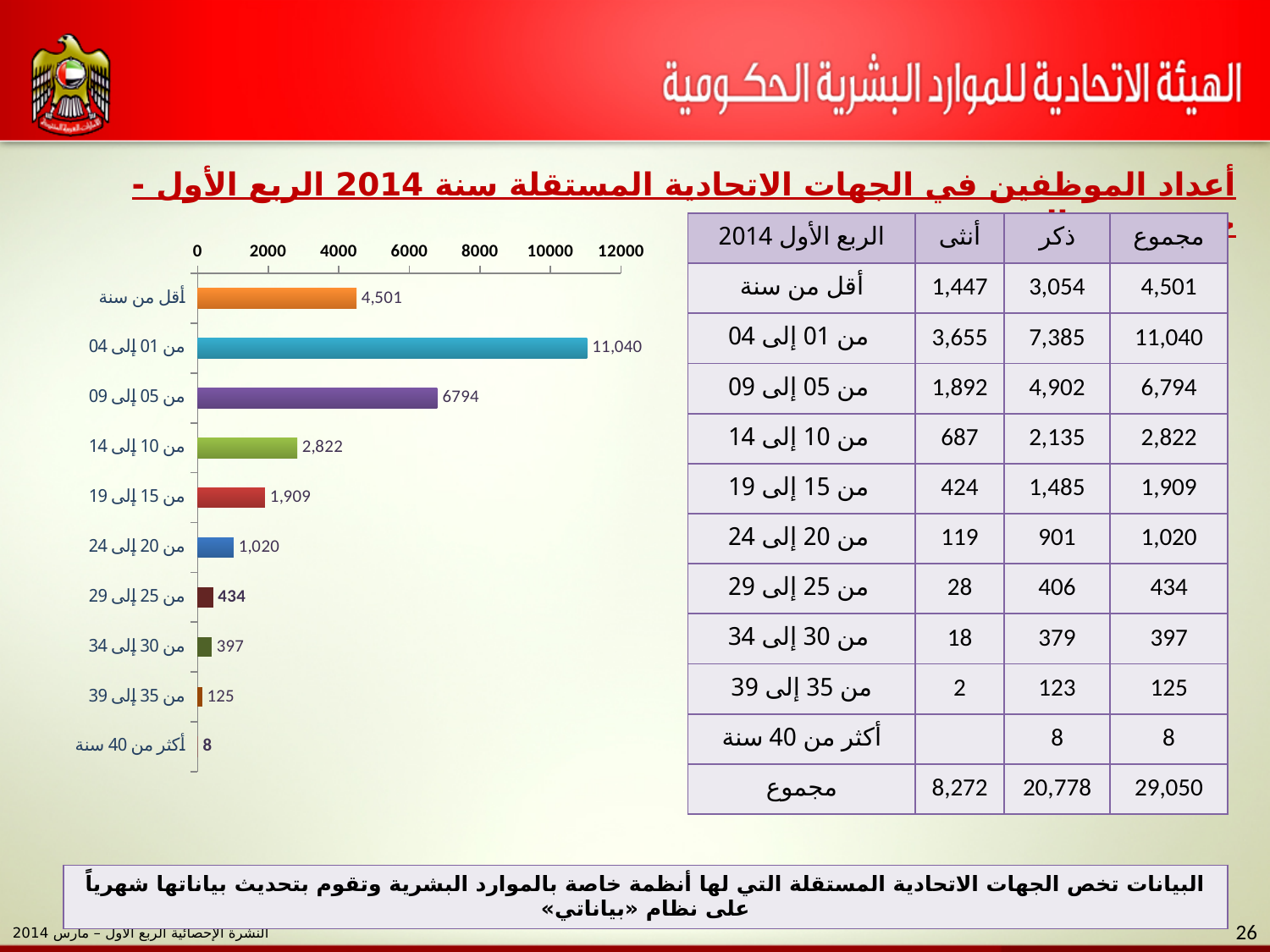
Which category has the lowest value in the bar chart? أكثر من 40 سنة What is the value for the category "أقل من سنة" in the bar chart? 4,501 Is the value for "من 20 إلى 24" in the bar chart greater or less than 2000? less What is the maximum value shown on the horizontal axis of the bar chart? 12000 What is the value for the category "من 35 إلى 39" in the bar chart? 125 How many categories does the bar chart show? 10 Which is larger in the bar chart, the value for "من 25 إلى 29" or the value for "من 30 إلى 34"? من 25 إلى 29 What is the value for the category "من 05 إلى 09" in the bar chart? 6794 Which category has the highest value in the bar chart? من 01 إلى 04 What kind of chart is shown on the slide? bar chart What is the difference between the values for "من 10 إلى 14" and "من 15 إلى 19" in the bar chart? 913 What is the value for the category "من 01 إلى 04" in the bar chart? 11,040